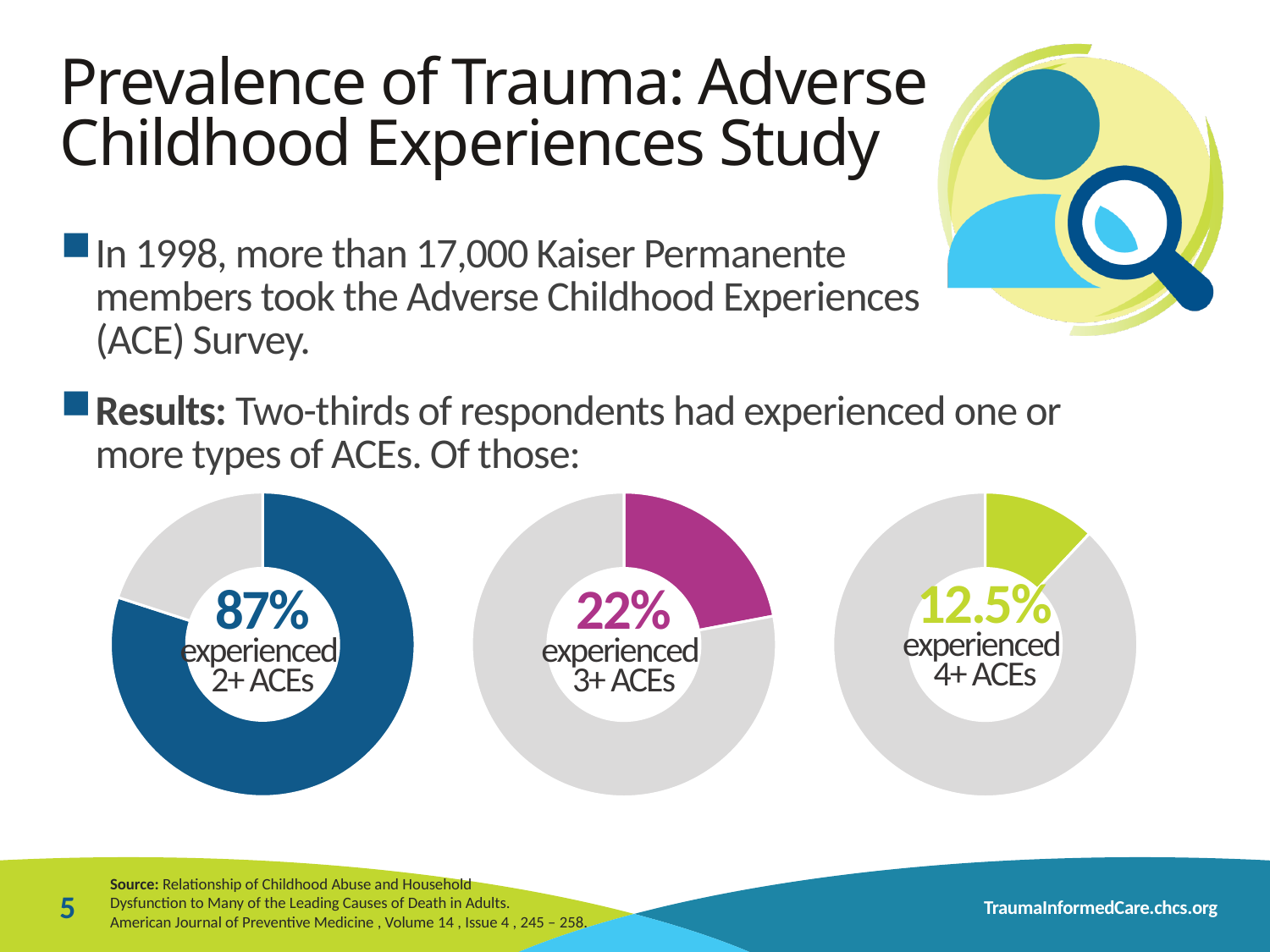
What percentage of respondents experienced 2+ ACEs according to the left donut chart? 87% What percentage of respondents experienced 3+ ACEs according to the middle donut chart? 22% Which is larger: the percentage who experienced 3+ ACEs or the percentage who experienced 4+ ACEs? 3+ ACEs Which of the three donut charts shows the highest percentage? 87% experienced 2+ ACEs What is the difference between the percentage who experienced 3+ ACEs and the percentage who experienced 4+ ACEs? 9.5% What percentage of respondents experienced 4+ ACEs according to the right donut chart? 12.5% What colour is the highlighted segment in the right donut chart (4+ ACEs)? Lime green What kind of charts are used to show the ACE percentages on the slide? Donut (pie) charts What is the difference between the percentage who experienced 2+ ACEs and the percentage who experienced 3+ ACEs? 65% What colour is the highlighted segment in the middle donut chart (3+ ACEs)? Magenta/purple Which of the three donut charts shows the lowest percentage? 12.5% experienced 4+ ACEs How many donut charts are shown on the slide? 3